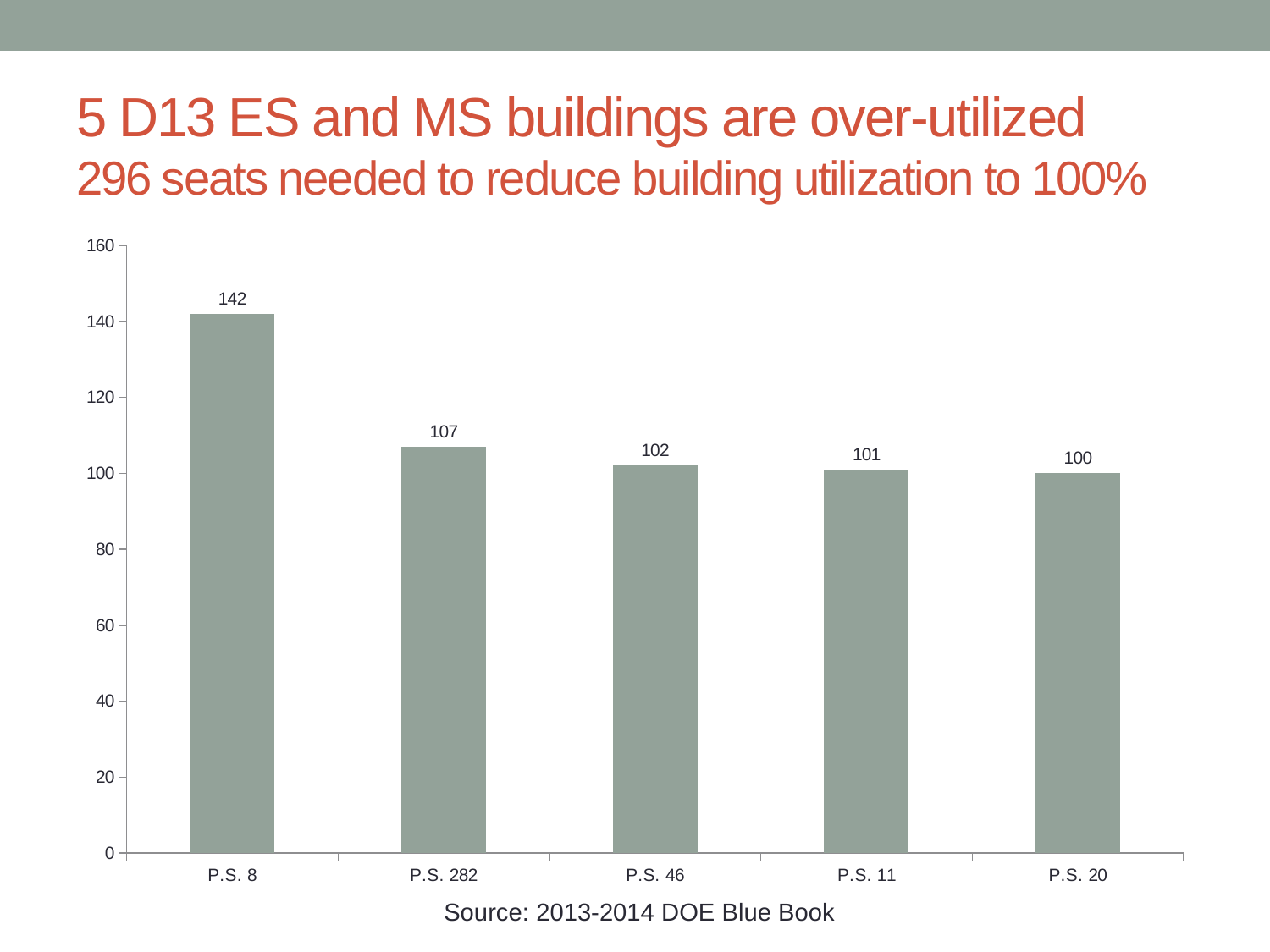
What is the value for P.S. 46? 102 What is the value for P.S. 282? 107 Do the values rise or fall from left to right along the x axis? fall Which is larger, the value for P.S. 282 or the value for P.S. 11? P.S. 282 Is the value for P.S. 8 greater or less than 120? greater Which category has the highest value? P.S. 8 What is the value for P.S. 20? 100 How many categories are shown on the x axis? 5 What is the difference between the values for P.S. 8 and P.S. 282? 35 Which category has the lowest value? P.S. 20 What is the value for P.S. 8? 142 What kind of chart is shown on the slide? bar chart